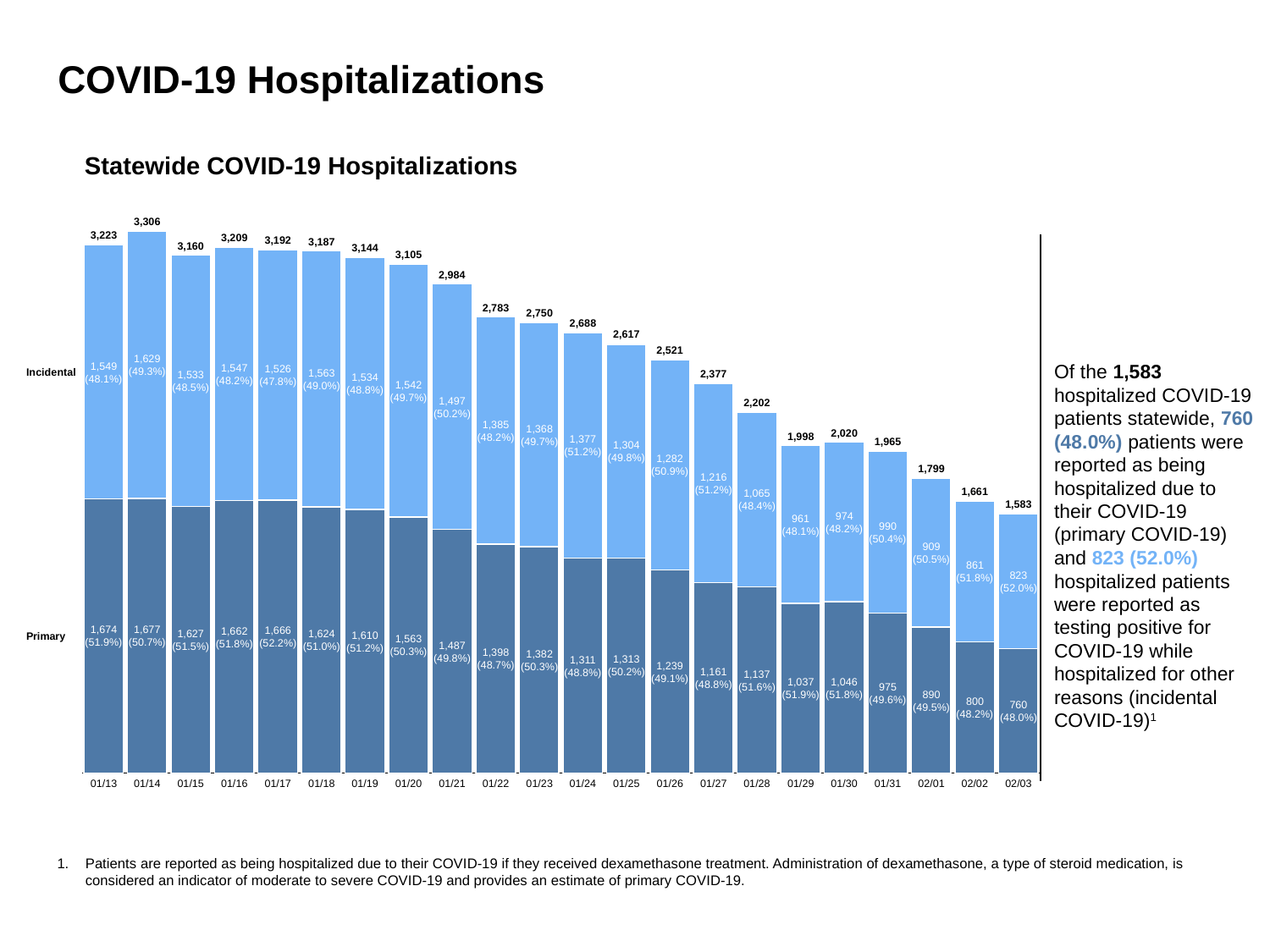
On which date is the total number of hospitalizations lowest? 02/03 What kind of chart is used to show the statewide hospitalizations? Stacked bar chart How many Primary COVID-19 hospitalizations are shown for 02/03? 760 How many series does the chart show? 2 Do total hospitalizations generally rise or fall from 01/14 to 02/03? Fall What is the total number of statewide COVID-19 hospitalizations on 01/14? 3,306 How many dates are shown on the x axis? 22 What percentage of hospitalizations on 01/26 were Incidental? 50.9% What is the difference between the total hospitalizations on 01/13 and on 02/03? 1,640 Which is larger on 01/28: the Primary value or the Incidental value? Primary On which date is the total number of hospitalizations highest? 01/14 What is the Incidental value for 01/21? 1,497